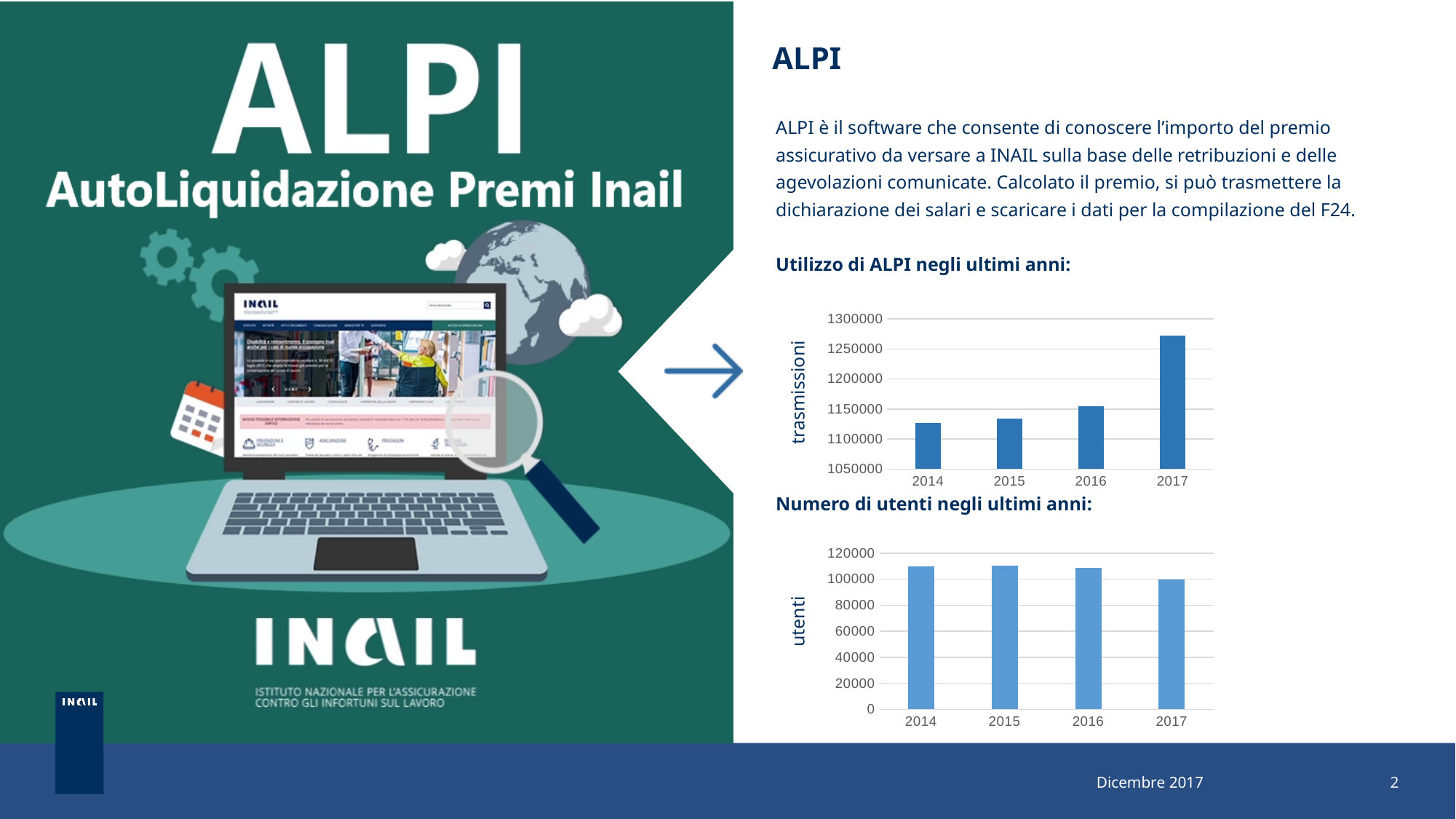
How many years are shown on the x axis of the 'Numero di utenti negli ultimi anni' chart? 4 What is the y-axis label of the 'Numero di utenti negli ultimi anni' chart? utenti In the 'Numero di utenti negli ultimi anni' chart, which year has more utenti, 2014 or 2017? 2014 In the 'Utilizzo di ALPI negli ultimi anni' chart, is the value for 2017 greater or less than 1250000? greater In the 'Numero di utenti negli ultimi anni' chart, is the value for 2017 greater or less than 120000? less In the 'Utilizzo di ALPI negli ultimi anni' chart, is the value for 2016 greater or less than 1200000? less In the 'Numero di utenti negli ultimi anni' chart, which year has the lowest number of utenti? 2017 In the 'Utilizzo di ALPI negli ultimi anni' chart, which year has more trasmissioni, 2014 or 2017? 2017 In the 'Utilizzo di ALPI negli ultimi anni' chart, do the values rise or fall from 2014 to 2017? rise In the 'Utilizzo di ALPI negli ultimi anni' chart, which year has the highest number of trasmissioni? 2017 What kind of chart is the 'Utilizzo di ALPI negli ultimi anni' chart? bar chart